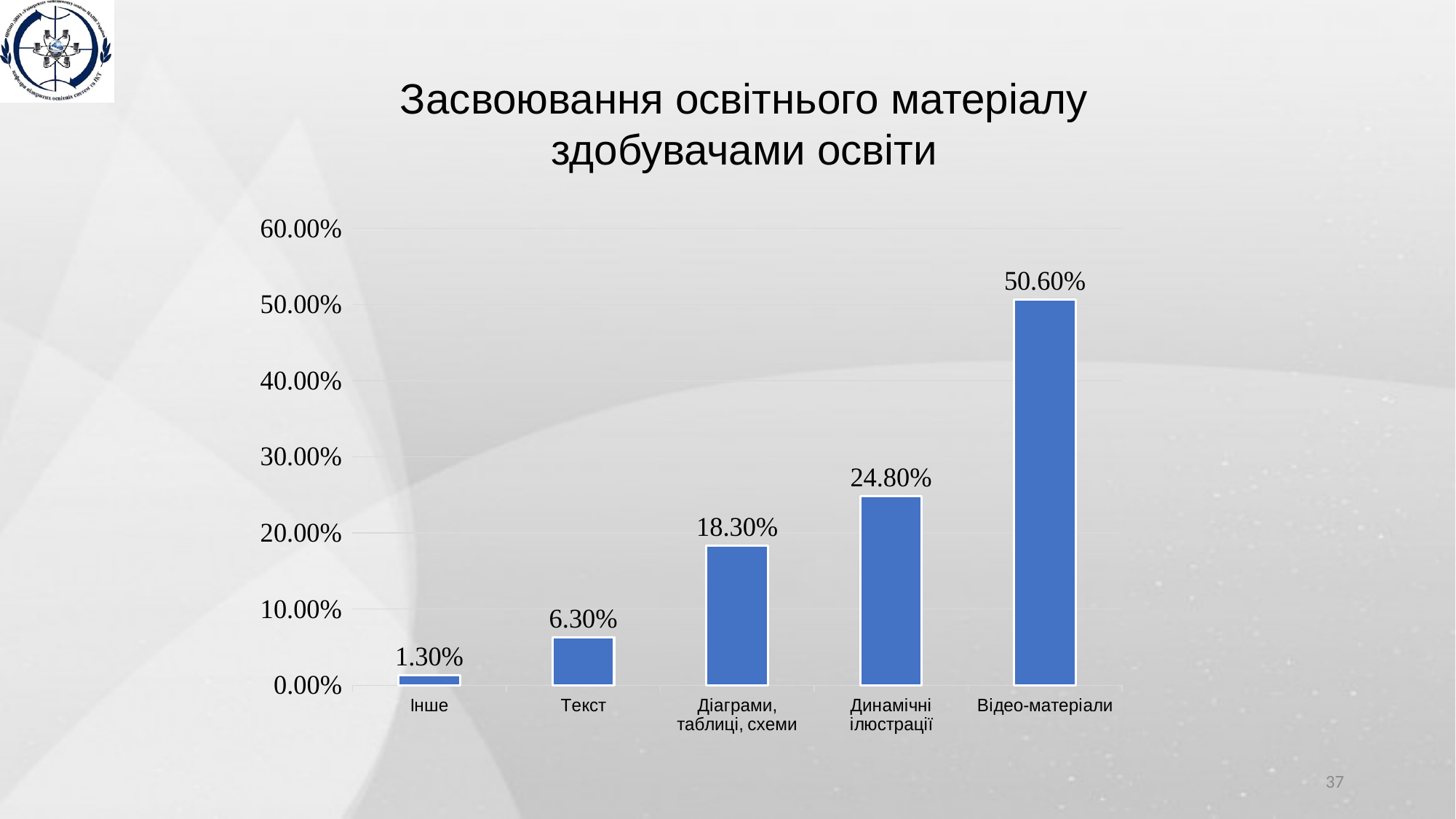
What is the value for Інше? 1.30% Do the values rise or fall from left to right along the x axis? Rise What is the value for Відео-матеріали? 50.60% Which category has the lowest value? Інше What is the difference between the values for Діаграми, таблиці, схеми and Текст? 12.00% What kind of chart is shown on the slide? Bar chart What is the difference between the values for Відео-матеріали and Динамічні ілюстрації? 25.80% Which category has the highest value? Відео-матеріали How many categories are shown on the x axis? 5 Which is larger, the value for Діаграми, таблиці, схеми or the value for Динамічні ілюстрації? Динамічні ілюстрації What is the value for Динамічні ілюстрації? 24.80% What is the value for Текст? 6.30%